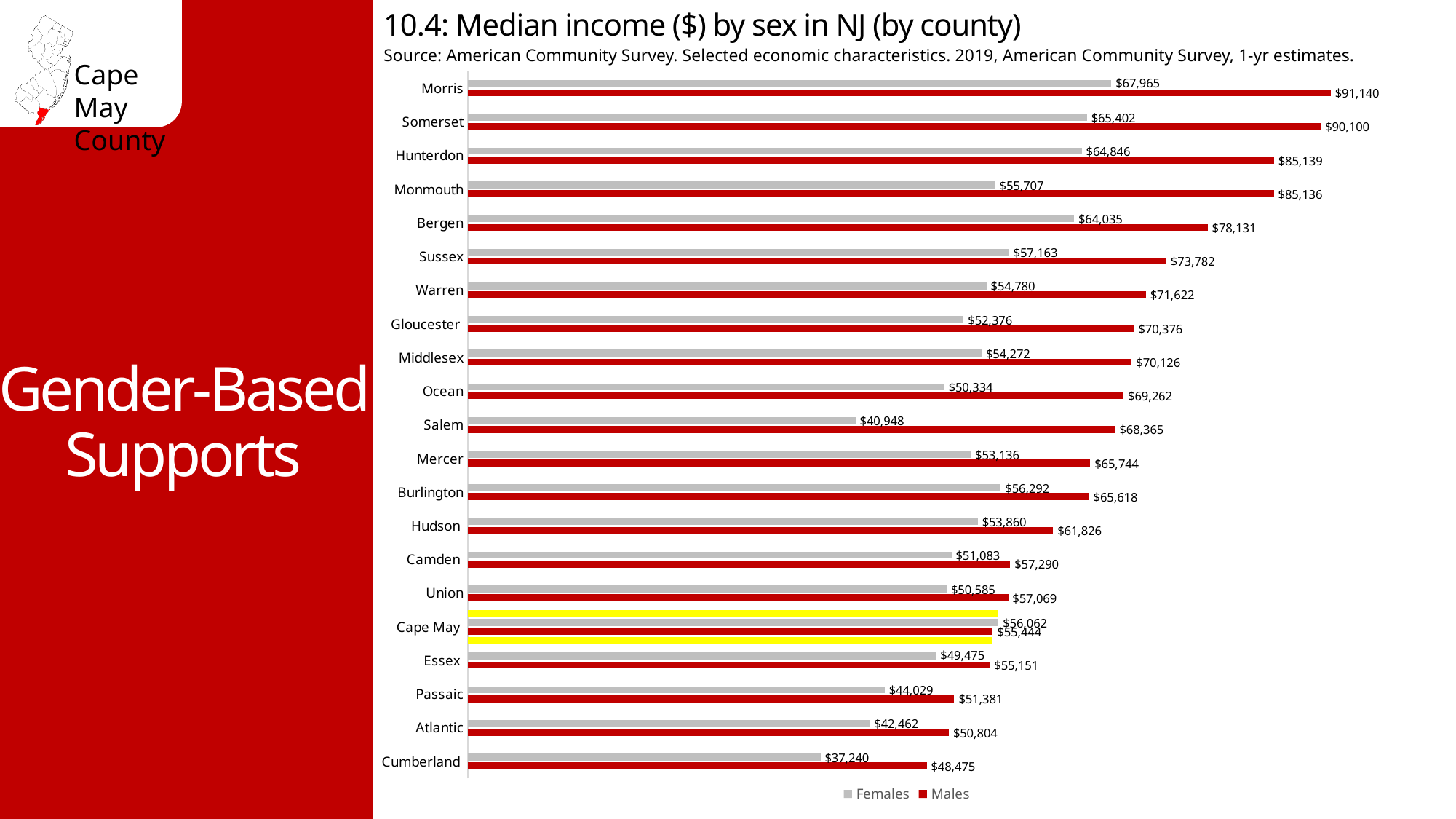
Which county has the highest median income for males? Morris Which county has a higher female median income, Bergen or Monmouth? Bergen What is the difference between the male and female median incomes in Cumberland County? $11,235 Which county has the lowest median income for females? Cumberland Which county's bars are highlighted in yellow? Cape May How many counties are shown in the chart? 21 What is the median income for females in Salem County? $40,948 How many series does the legend list? 2 What kind of chart is shown on the slide? Bar chart What is the difference between the male and female median incomes in Morris County? $23,175 What is the median income for males in Hudson County? $61,826 What is the median income for males in Morris County? $91,140